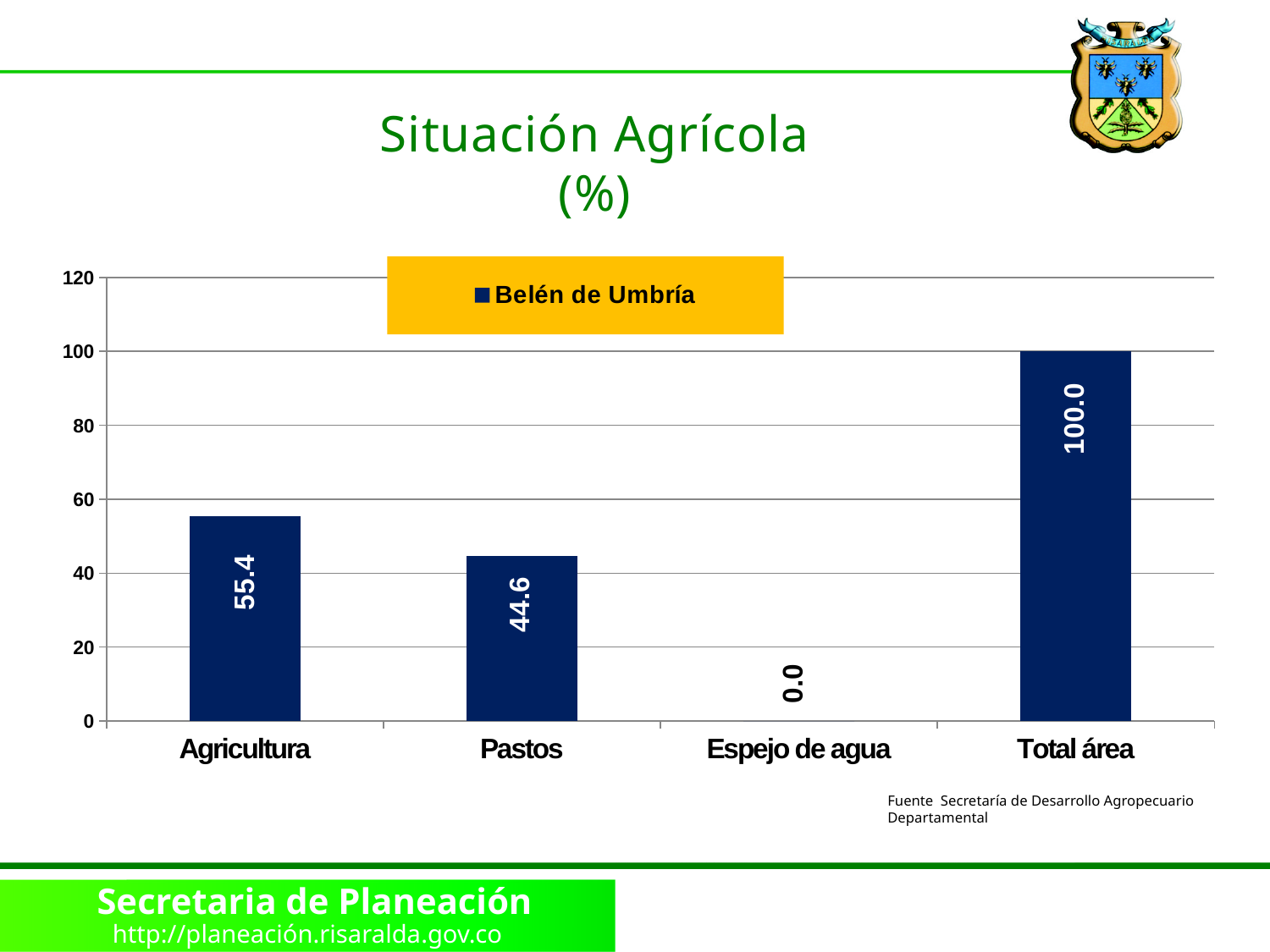
What is the value for Pastos? 44.6 What series name does the legend show? Belén de Umbría What kind of chart is shown on the slide? bar chart What is the value for Total área? 100.0 What is the value for Agricultura? 55.4 Which is larger, the value for Agricultura or the value for Pastos? Agricultura What is the difference between the values for Agricultura and Pastos? 10.8 How many categories are shown on the x axis? 4 Which category has the lowest value? Espejo de agua What is the value for Espejo de agua? 0.0 Is the value for Pastos greater or less than 60? less Which category has the highest value? Total área